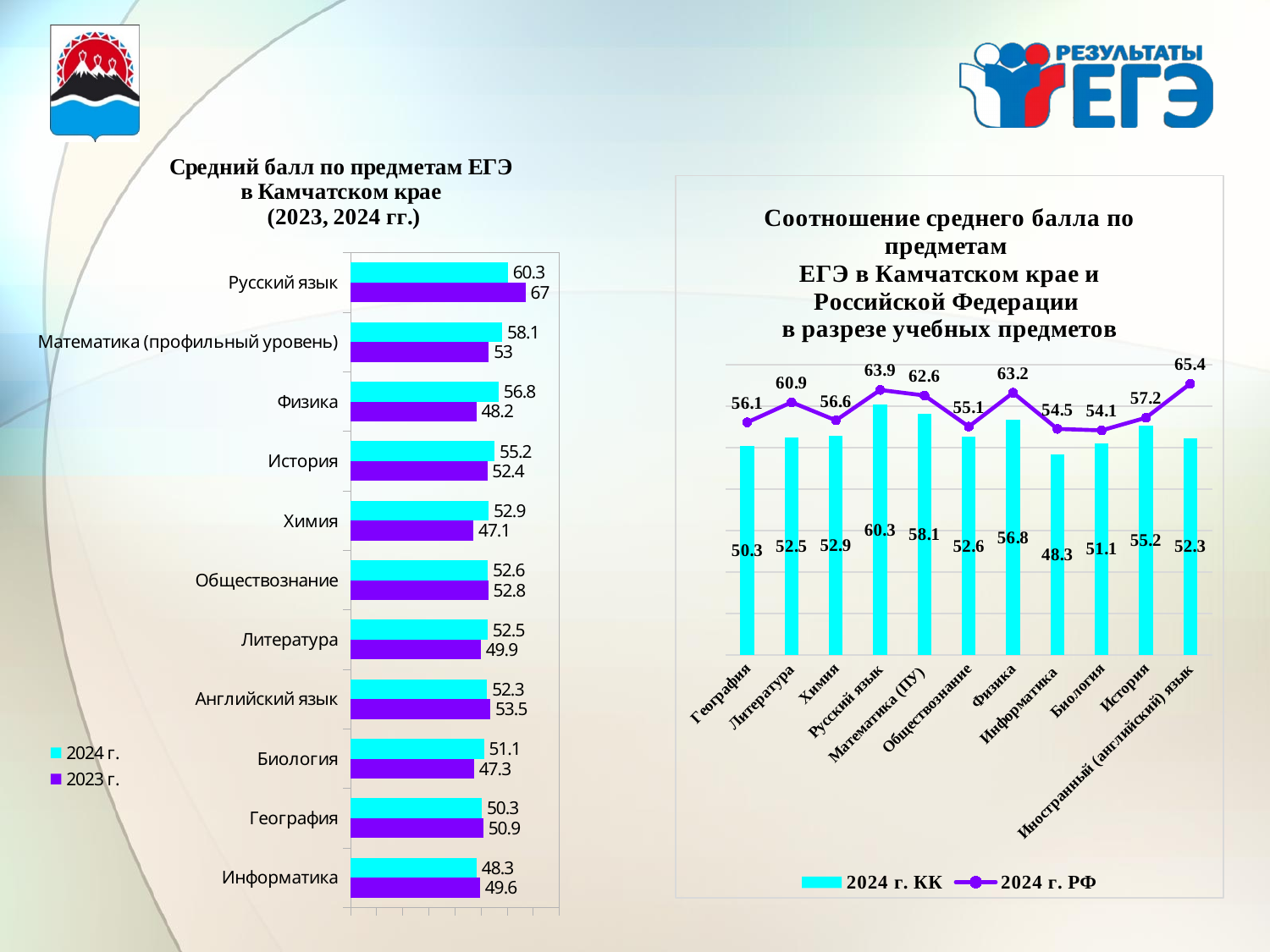
In the left chart (Средний балл по предметам ЕГЭ в Камчатском крае), which subject has the lowest 2024 value? Информатика What type of chart is the left chart (Средний балл по предметам ЕГЭ в Камчатском крае)? Bar chart In the left chart (Средний балл по предметам ЕГЭ в Камчатском крае), how many series does the legend list? 2 In the right chart (Соотношение среднего балла по предметам ЕГЭ в Камчатском крае и Российской Федерации), what is the difference between the 2024 г. РФ and 2024 г. КК values for Информатика? 6.2 In the left chart (Средний балл по предметам ЕГЭ в Камчатском крае), which subject has the highest 2023 value? Русский язык In the left chart (Средний балл по предметам ЕГЭ в Камчатском крае), what is the 2023 value for Физика? 48.2 In the left chart (Средний балл по предметам ЕГЭ в Камчатском крае), what is the difference between the 2023 and 2024 values for Русский язык? 6.7 In the right chart (Соотношение среднего балла по предметам ЕГЭ в Камчатском крае и Российской Федерации), what is the 2024 г. РФ value for Физика? 63.2 In the right chart (Соотношение среднего балла по предметам ЕГЭ в Камчатском крае и Российской Федерации), which subject has the highest 2024 г. РФ value? Иностранный (английский) язык In the left chart (Средний балл по предметам ЕГЭ в Камчатском крае), what is the 2024 value for Русский язык? 60.3 In the left chart (Средний балл по предметам ЕГЭ в Камчатском крае), which is larger for Биология: the 2024 value or the 2023 value? 2024 г. In the left chart (Средний балл по предметам ЕГЭ в Камчатском крае), how many subjects are shown? 11